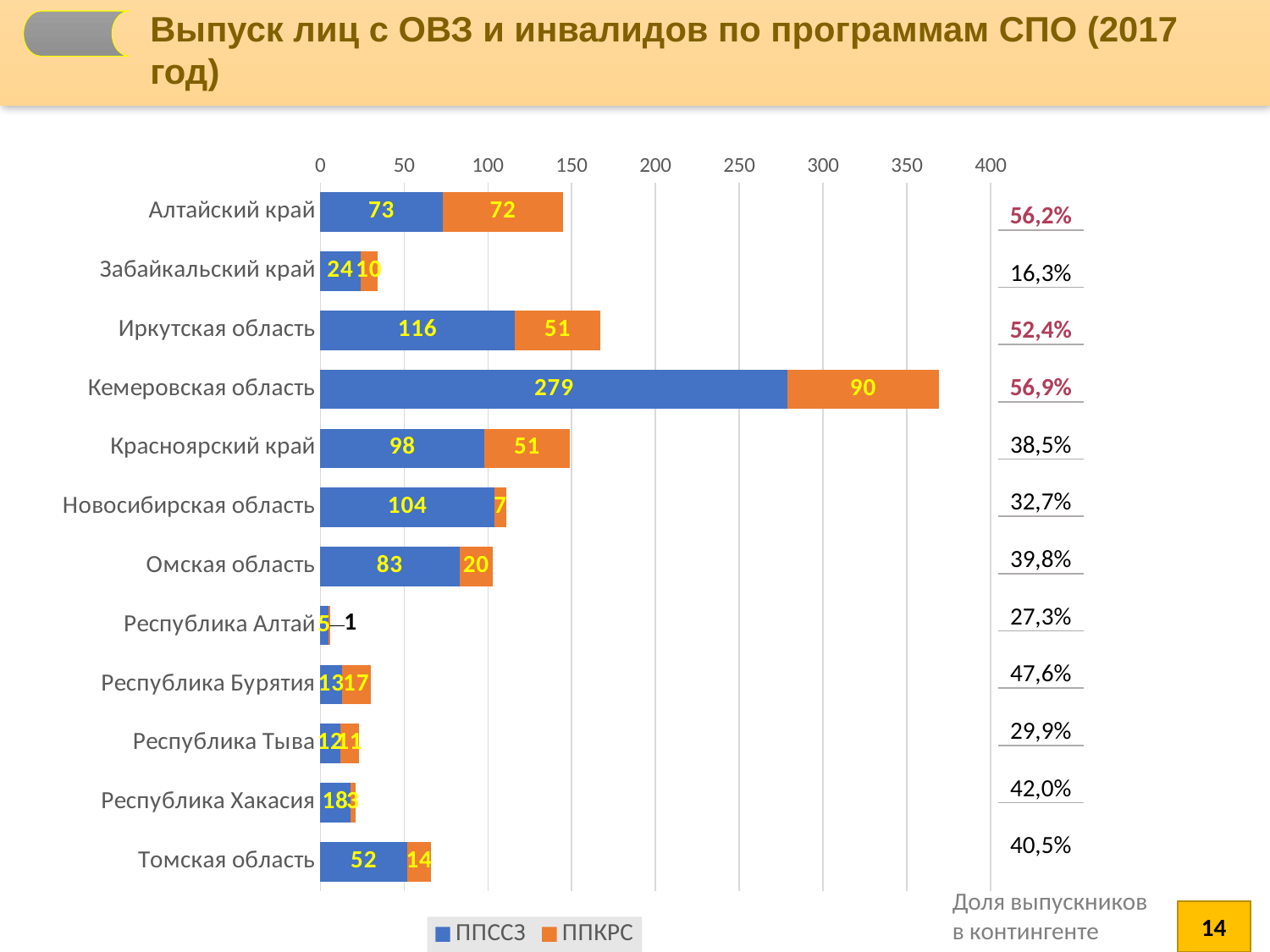
What is the ППКРС value for Новосибирская область? 7 What is the difference between the ППССЗ and ППКРС values for Кемеровская область? 189 What kind of chart is shown on the slide? bar chart Which region has the highest ППССЗ value? Кемеровская область Which is larger, the ППССЗ value for Красноярский край or the ППССЗ value for Омская область? Красноярский край What is the ППКРС value for Алтайский край? 72 What is the ППССЗ value for Кемеровская область? 279 How many series does the legend list? 2 What are the two series names listed in the legend? ППССЗ and ППКРС How many regions are shown on the chart? 12 Is the total of the stacked bar for Кемеровская область greater or less than 350? greater What is the total of the stacked bar for Иркутская область? 167